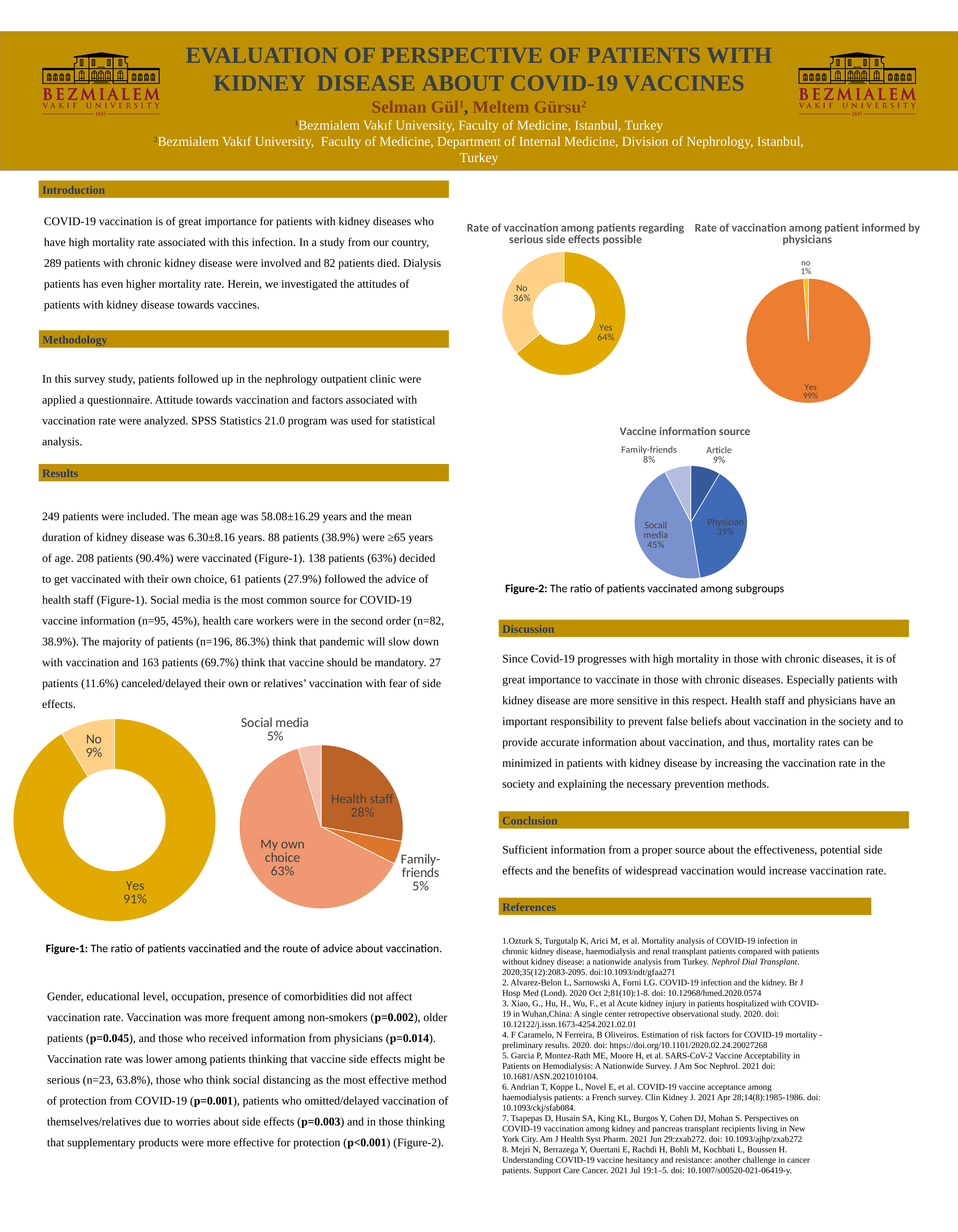
What kind of chart is the chart titled "Rate of vaccination among patient informed by physicians"? Pie chart In the chart titled "Vaccine information source", which source has the largest share? Socail media In the donut chart at the bottom left of the slide (Figure-1), what share is labelled "Yes"? 91% In the pie chart at the bottom left of the slide (Figure-1, route of advice), which is larger: "My own choice" or "Health staff"? My own choice In the chart titled "Rate of vaccination among patients regarding serious side effects possible", what share is labelled "Yes"? 64% In the chart titled "Rate of vaccination among patients regarding serious side effects possible", what share is labelled "No"? 36% In the chart titled "Vaccine information source", what share is labelled "Physician"? 39% In the chart titled "Vaccine information source", which source has the smallest share? Family-friends In the pie chart at the bottom left of the slide (Figure-1, route of advice), what share is labelled "Health staff"? 28% In the chart titled "Vaccine information source", how many slices does the pie have? 4 In the chart titled "Rate of vaccination among patient informed by physicians", what share is labelled "Yes"? 99% In the chart titled "Rate of vaccination among patient informed by physicians", what is the difference between the "Yes" and "no" shares? 98%